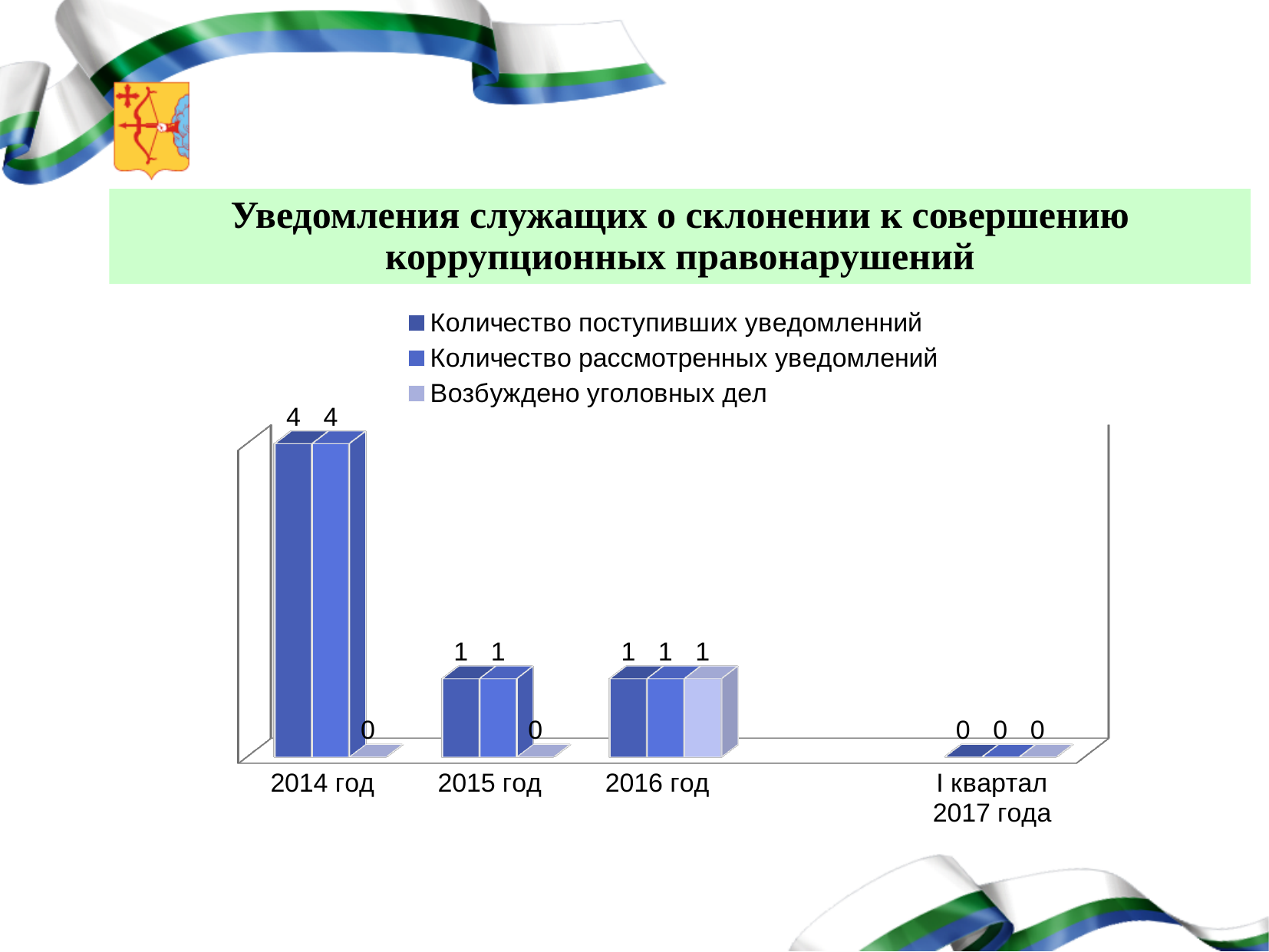
How many categories are shown on the x axis? 4 What kind of chart is shown on the slide? Bar chart Which is larger: "Возбуждено уголовных дел" for 2016 год or for 2015 год? 2016 год Does "Количество поступивших уведомленний" rise or fall from 2014 год to 2015 год? Fall What is the value of "Возбуждено уголовных дел" for 2014 год? 0 Which category has the lowest value for "Количество рассмотренных уведомлений"? I квартал 2017 года What is the value of "Количество поступивших уведомленний" for 2014 год? 4 Which category has the highest value for "Количество поступивших уведомленний"? 2014 год What is the value of "Количество рассмотренных уведомлений" for 2015 год? 1 What is the difference between "Количество поступивших уведомленний" for 2014 год and for 2015 год? 3 What is the value of "Возбуждено уголовных дел" for 2016 год? 1 How many series does the legend list? 3